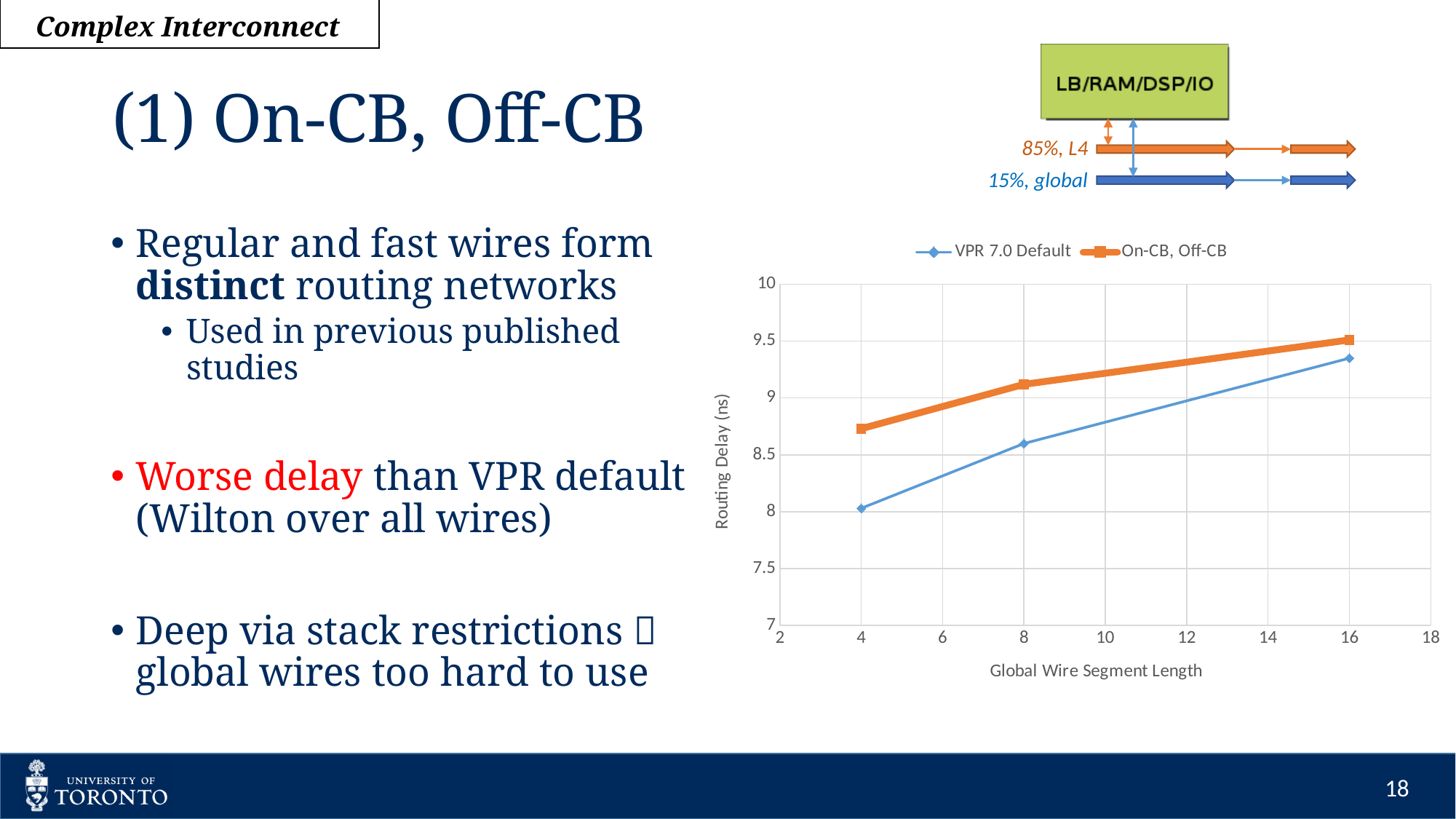
What is the label of the chart's y axis? Routing Delay (ns) Is the routing delay for VPR 7.0 Default at segment length 8 greater or less than 9? less What kind of chart is shown on the slide? line chart Is the routing delay for On-CB, Off-CB at segment length 16 greater or less than 9? greater How many series does the chart legend list? 2 What are the two series named in the chart legend? VPR 7.0 Default and On-CB, Off-CB How many data points are plotted for the On-CB, Off-CB series? 3 At segment length 4, which series has the higher routing delay? On-CB, Off-CB At which global wire segment length is the routing delay for VPR 7.0 Default highest? 16 Does routing delay rise or fall as global wire segment length increases for the VPR 7.0 Default series? rise Is the routing delay for VPR 7.0 Default at segment length 4 greater or less than 8.5? less